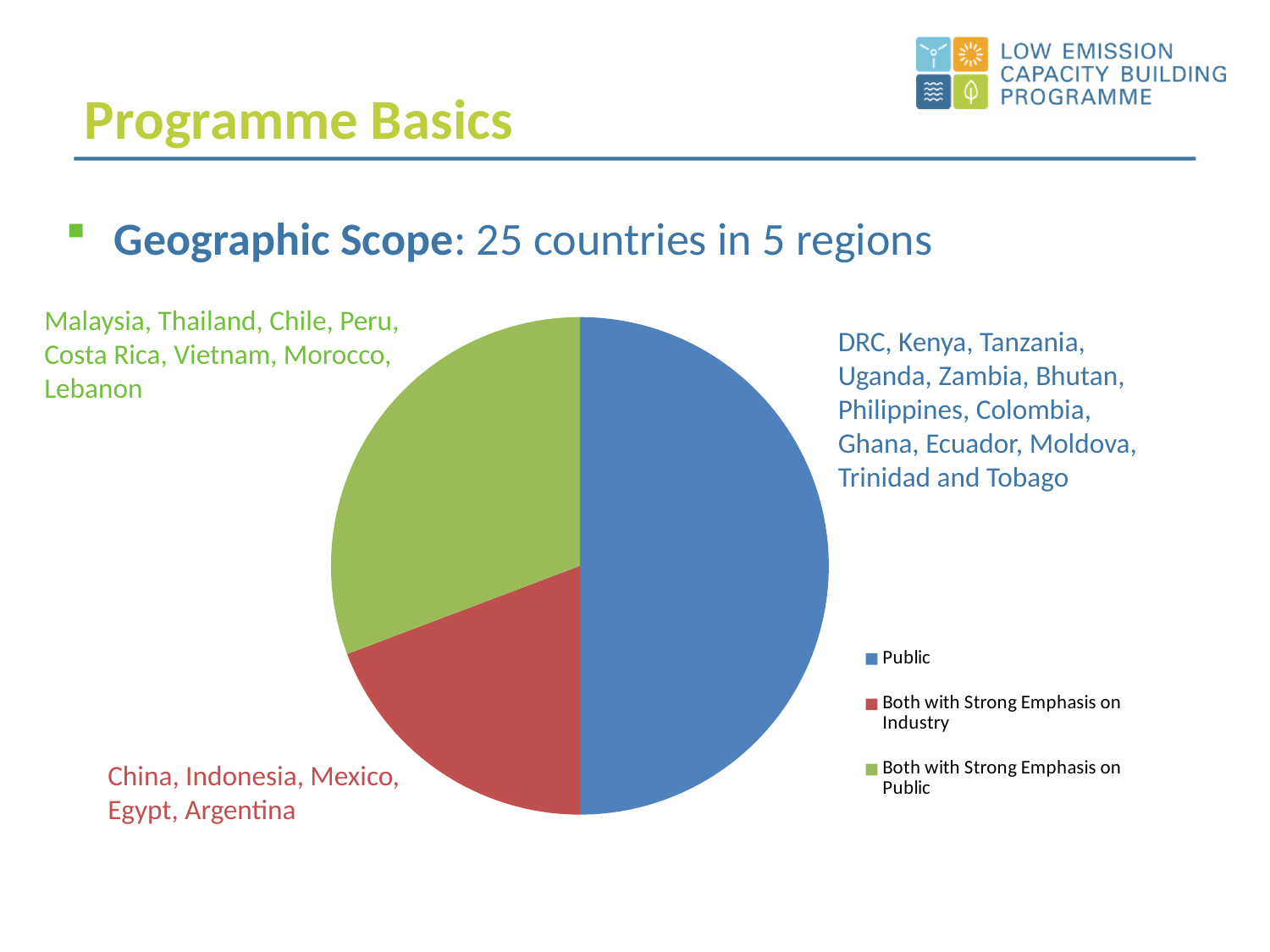
How many countries are listed next to the red slice (China, Indonesia, Mexico, Egypt, Argentina)? 5 Which legend entry is shown in red? Both with Strong Emphasis on Industry Which slice is larger: Public or Both with Strong Emphasis on Public? Public Which category has the largest slice of the pie chart? Public Which slice is larger: Both with Strong Emphasis on Industry or Both with Strong Emphasis on Public? Both with Strong Emphasis on Public How many entries does the legend of the pie chart list? 3 What kind of chart is shown on the slide? Pie chart Which category has the smallest slice of the pie chart? Both with Strong Emphasis on Industry How many slices does the pie chart have? 3 How many countries are listed next to the green slice? 8 What colour is the Public slice in the pie chart? Blue